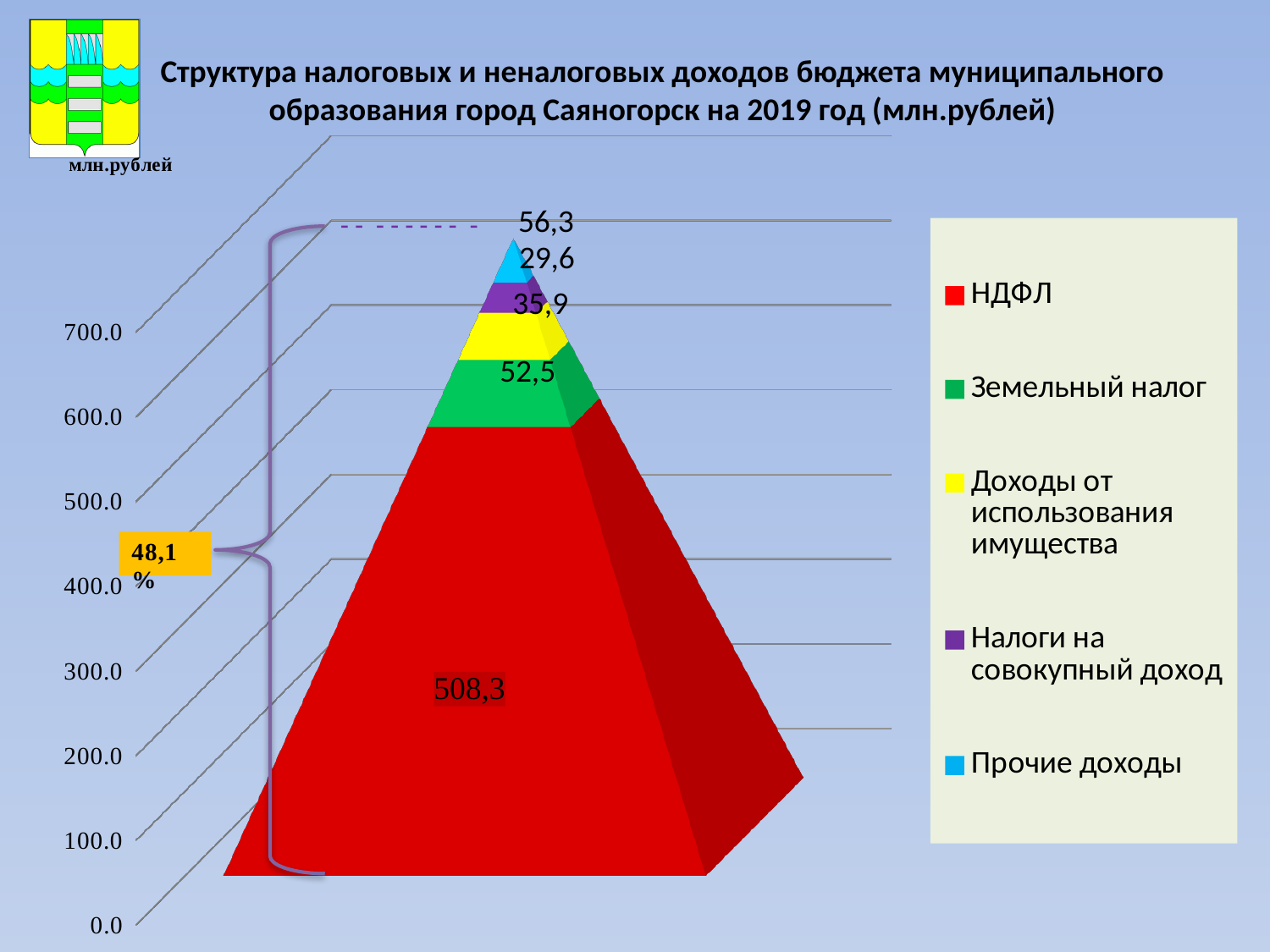
What is the value for НДФЛ? 508,3 What is the value for Прочие доходы? 56,3 Which series has the lowest value? Налоги на совокупный доход What is the difference between the values for Прочие доходы and Земельный налог? 3,8 Which series has the highest value? НДФЛ What kind of chart is shown on the slide? Stacked bar chart What is the value for Доходы от использования имущества? 35,9 What is the value for Налоги на совокупный доход? 29,6 What is the value for Земельный налог? 52,5 What is the total of all the stacked segments? 682,6 How many series does the legend list? 5 Which is larger, the value for Доходы от использования имущества or the value for Налоги на совокупный доход? Доходы от использования имущества